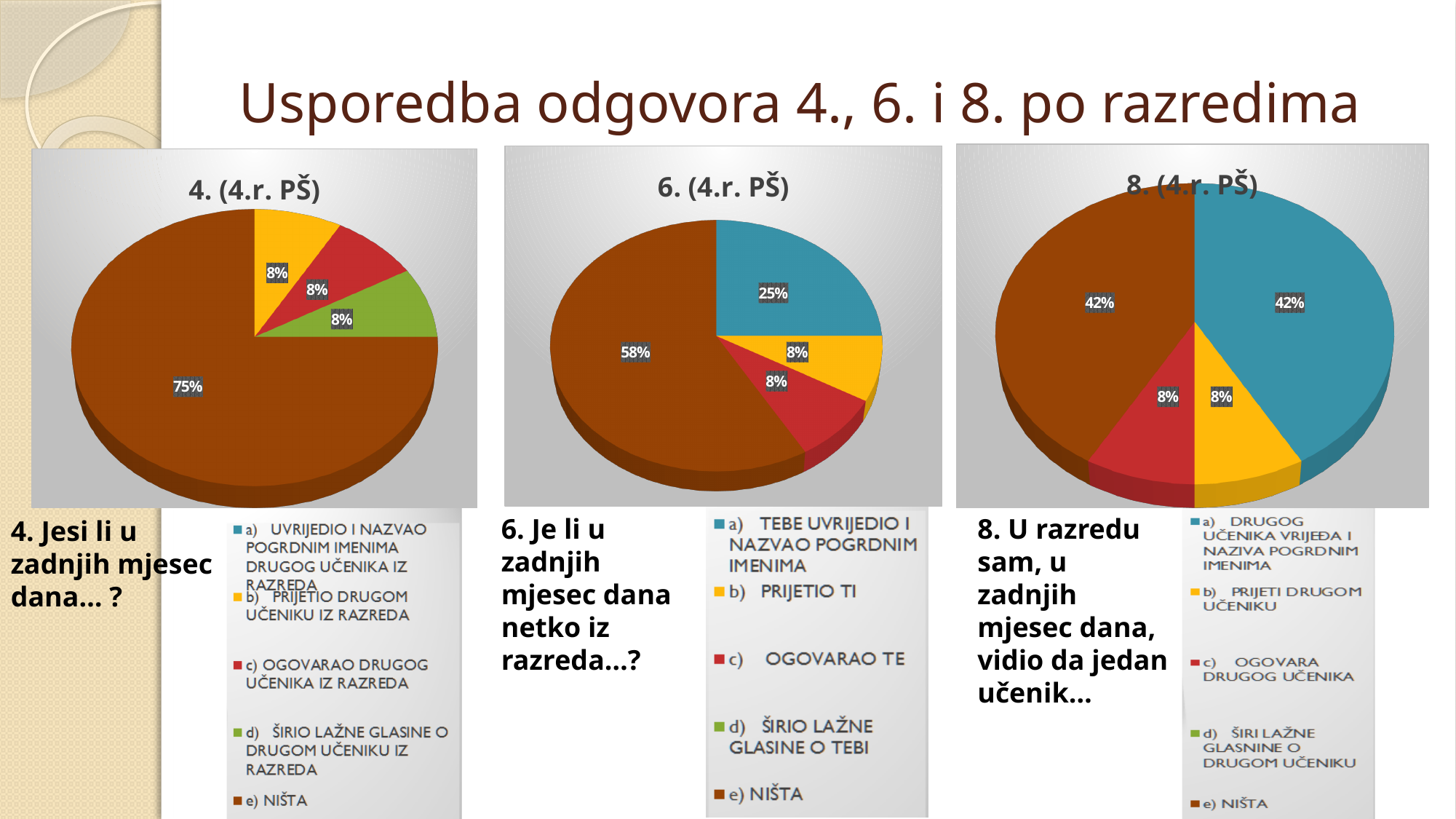
In the chart titled "8. (4.r. PŠ)", what percentage is shown for the slice "b) PRIJETI DRUGOM UČENIKU"? 8% In the chart titled "6. (4.r. PŠ)", which category has the largest slice? e) NIŠTA In the chart titled "6. (4.r. PŠ)", what is the difference between the "e) NIŠTA" slice and the "a) TEBE UVRIJEDIO I NAZVAO POGRDNIM IMENIMA" slice? 33% In the chart titled "6. (4.r. PŠ)", which is larger: the slice for "a) TEBE UVRIJEDIO I NAZVAO POGRDNIM IMENIMA" or the slice for "b) PRIJETIO TI"? a) TEBE UVRIJEDIO I NAZVAO POGRDNIM IMENIMA In the chart titled "4. (4.r. PŠ)", which category has the largest slice? e) NIŠTA How many entries does the legend of the chart titled "8. (4.r. PŠ)" list? 5 In the chart titled "8. (4.r. PŠ)", what percentage is shown for the slice "a) DRUGOG UČENIKA VRIJEĐA I NAZIVA POGRDNIM IMENIMA"? 42% In the chart titled "6. (4.r. PŠ)", what percentage is shown for the slice "e) NIŠTA"? 58% In the chart titled "4. (4.r. PŠ)", what percentage is shown for the slice "e) NIŠTA"? 75% In the chart titled "6. (4.r. PŠ)", what percentage is shown for the slice "a) TEBE UVRIJEDIO I NAZVAO POGRDNIM IMENIMA"? 25% What type of chart is the chart titled "8. (4.r. PŠ)"? Pie chart How many slices are shown in the chart titled "4. (4.r. PŠ)"? 4